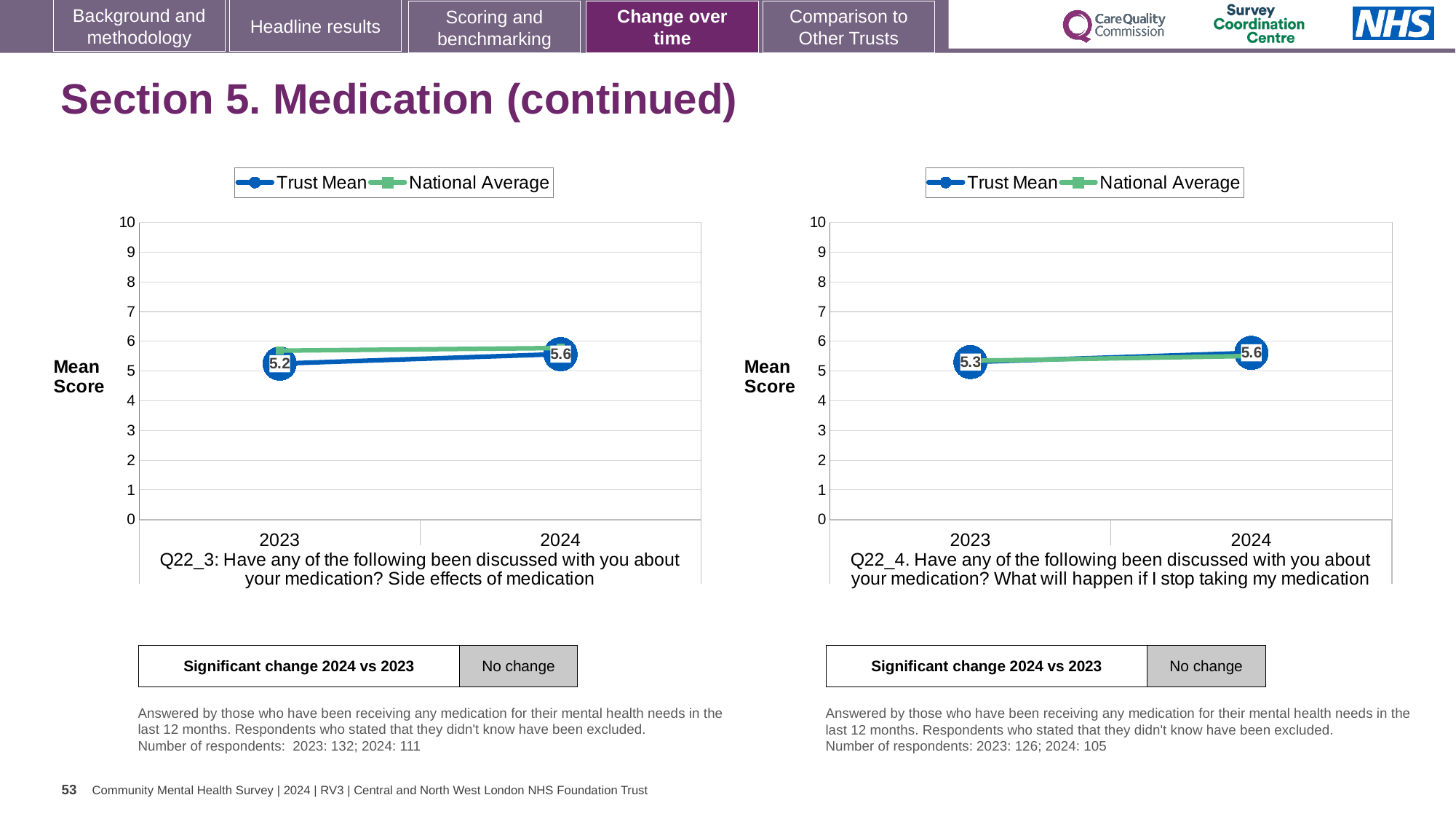
How many years are plotted on the x axis of the left chart (Q22_3)? 2 In the right chart (Q22_4), is the National Average for 2024 greater or less than 6? less In the right chart (Q22_4), by how much did the Trust Mean change from 2023 to 2024? 0.3 In the right chart (Q22_4), what is the Trust Mean for 2023? 5.3 In the left chart (Q22_3), is the National Average for 2023 greater or less than 5? greater In the left chart (Q22_3), does the Trust Mean rise or fall from 2023 to 2024? rise In the right chart (Q22_4), what is the Trust Mean for 2024? 5.6 In the left chart (Q22_3), what is the Trust Mean for 2023? 5.2 What type of chart is used on the left (Q22_3)? line chart How many series does the legend of the right chart (Q22_4) list? 2 In the left chart (Q22_3), what is the Trust Mean for 2024? 5.6 In the left chart (Q22_3), by how much did the Trust Mean change from 2023 to 2024? 0.4